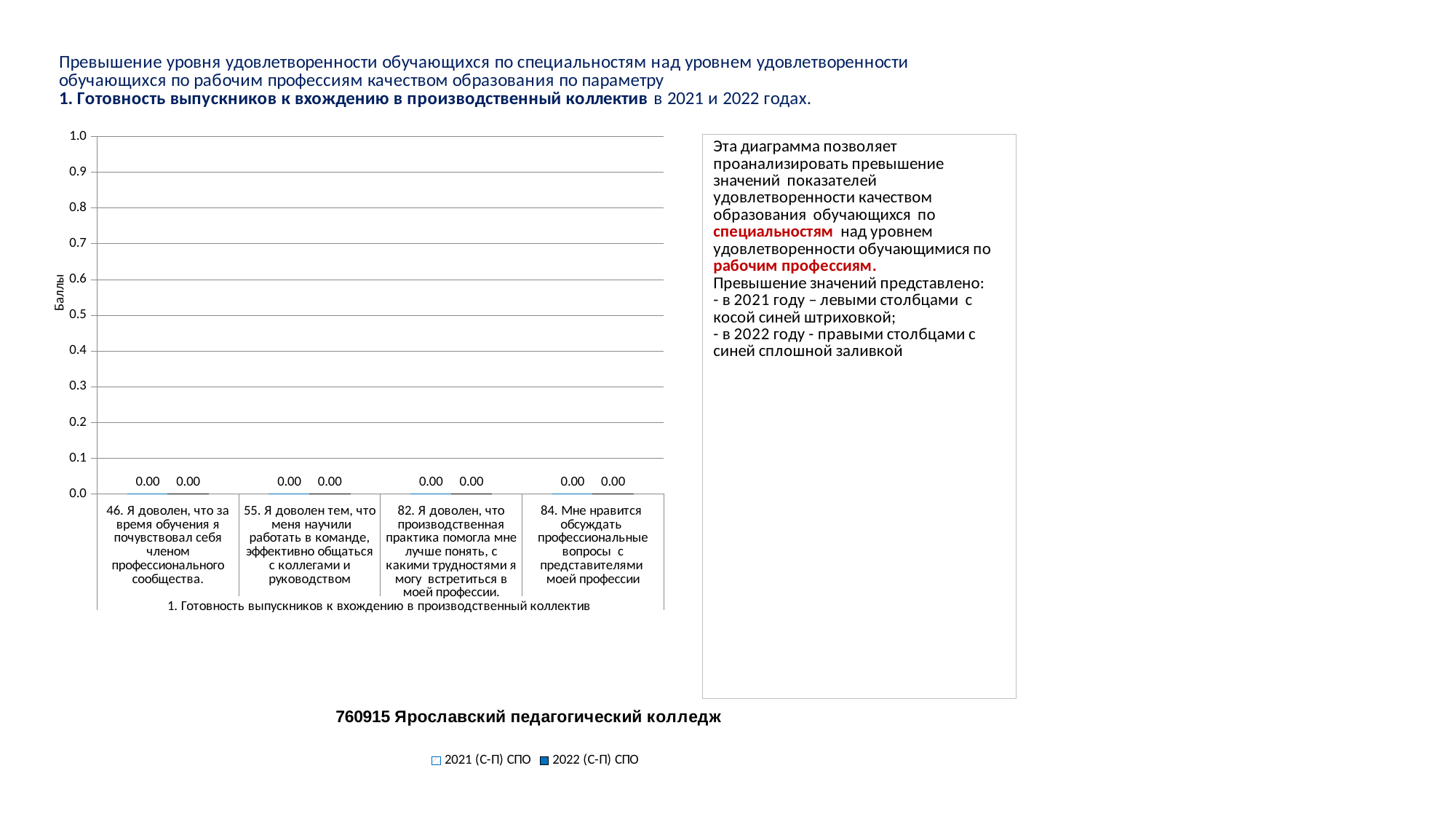
How many series does the legend list? 2 What is the value for 2022 (С-П) СПО for category 82 (Я доволен, что производственная практика помогла мне лучше понять, с какими трудностями я могу встретиться в моей профессии)? 0.00 What is the label of the vertical axis of the chart? Баллы What kind of chart is shown on the slide? Bar chart What is the difference between the 2021 (С-П) СПО and 2022 (С-П) СПО values for category 46? 0.00 What is the value for 2021 (С-П) СПО for category 46 (Я доволен, что за время обучения я почувствовал себя членом профессионального сообщества)? 0.00 What is the value for 2022 (С-П) СПО for category 84 (Мне нравится обсуждать профессиональные вопросы с представителями моей профессии)? 0.00 What are the two series names listed in the chart legend? 2021 (С-П) СПО and 2022 (С-П) СПО What is the value for 2021 (С-П) СПО for category 55 (Я доволен тем, что меня научили работать в команде)? 0.00 How many categories are shown on the x axis of the chart? 4 Do the values for 2022 (С-П) СПО rise or fall across the categories along the x axis? Neither, they stay at 0.00